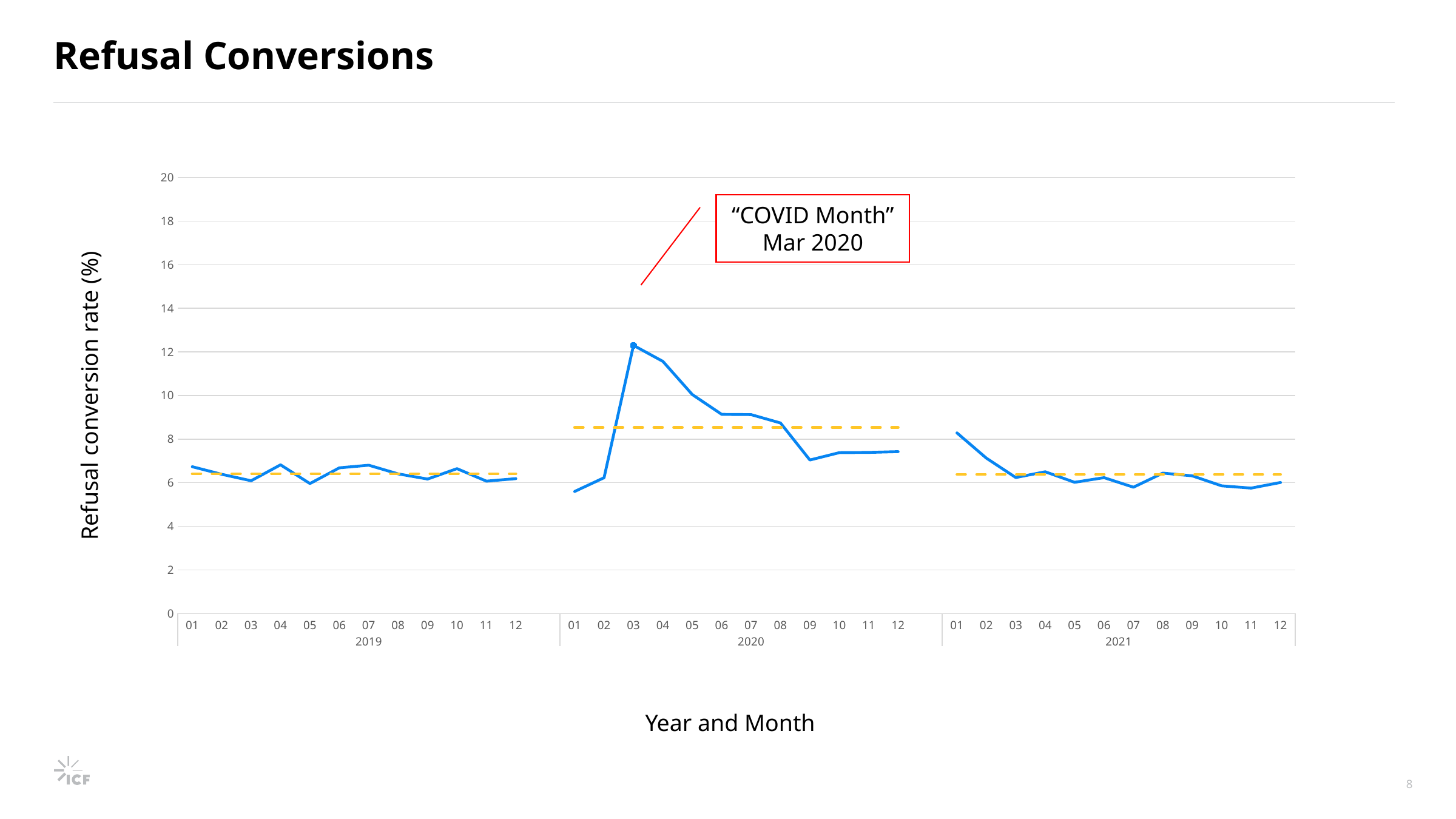
How many years are shown on the x axis? 3 Which has the higher refusal conversion rate, 01 2020 or 01 2021? 01 2021 Does the refusal conversion rate rise or fall from 03 2020 to 09 2020? fall Which month has the highest refusal conversion rate? 03 2020 (Mar 2020) Which has the higher refusal conversion rate, 03 2019 or 03 2020? 03 2020 Is the refusal conversion rate for 01 2020 greater or less than 6? less Is the refusal conversion rate for 04 2020 greater or less than 10? greater Is the refusal conversion rate for 03 2020 greater or less than 10? greater How many monthly data points are plotted in total? 36 What kind of chart is shown on the slide? line chart What month does the red annotation box label as the "COVID Month"? Mar 2020